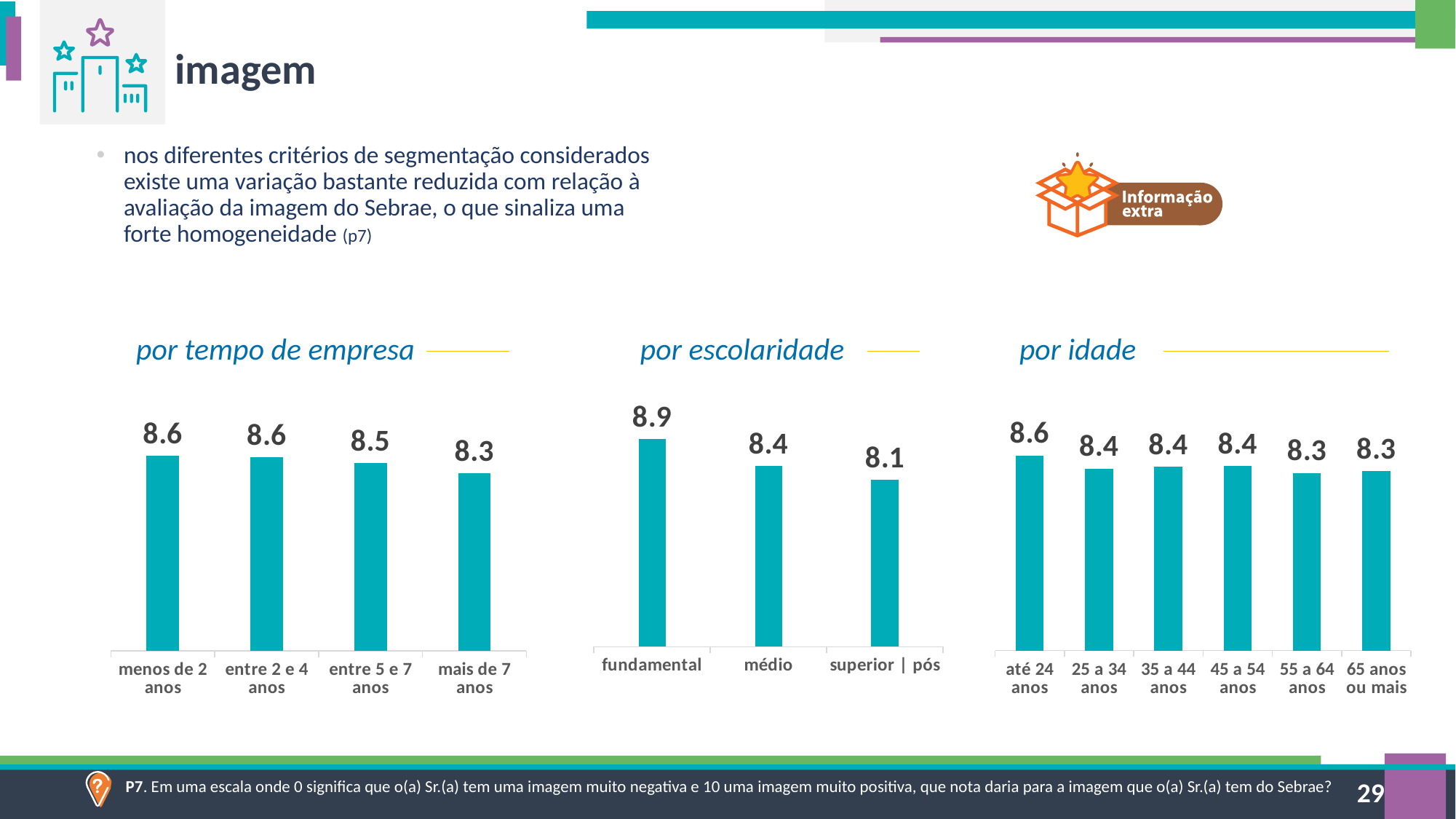
In the 'por tempo de empresa' chart, what is the value for 'mais de 7 anos'? 8.3 In the 'por idade' chart, which is larger: the value for 'até 24 anos' or the value for '65 anos ou mais'? até 24 anos In the 'por idade' chart, what is the value for '25 a 34 anos'? 8.4 In the 'por escolaridade' chart, which category has the lowest value? superior | pós In the 'por tempo de empresa' chart, what is the value for 'entre 5 e 7 anos'? 8.5 In the 'por escolaridade' chart, do the values rise or fall from left to right? fall What kind of chart is the 'por escolaridade' chart? bar chart In the 'por tempo de empresa' chart, how many categories are shown? 4 In the 'por idade' chart, how many categories are shown? 6 In the 'por escolaridade' chart, what is the difference between 'fundamental' and 'superior | pós'? 0.8 In the 'por escolaridade' chart, which category has the highest value? fundamental In the 'por idade' chart, which category has the highest value? até 24 anos